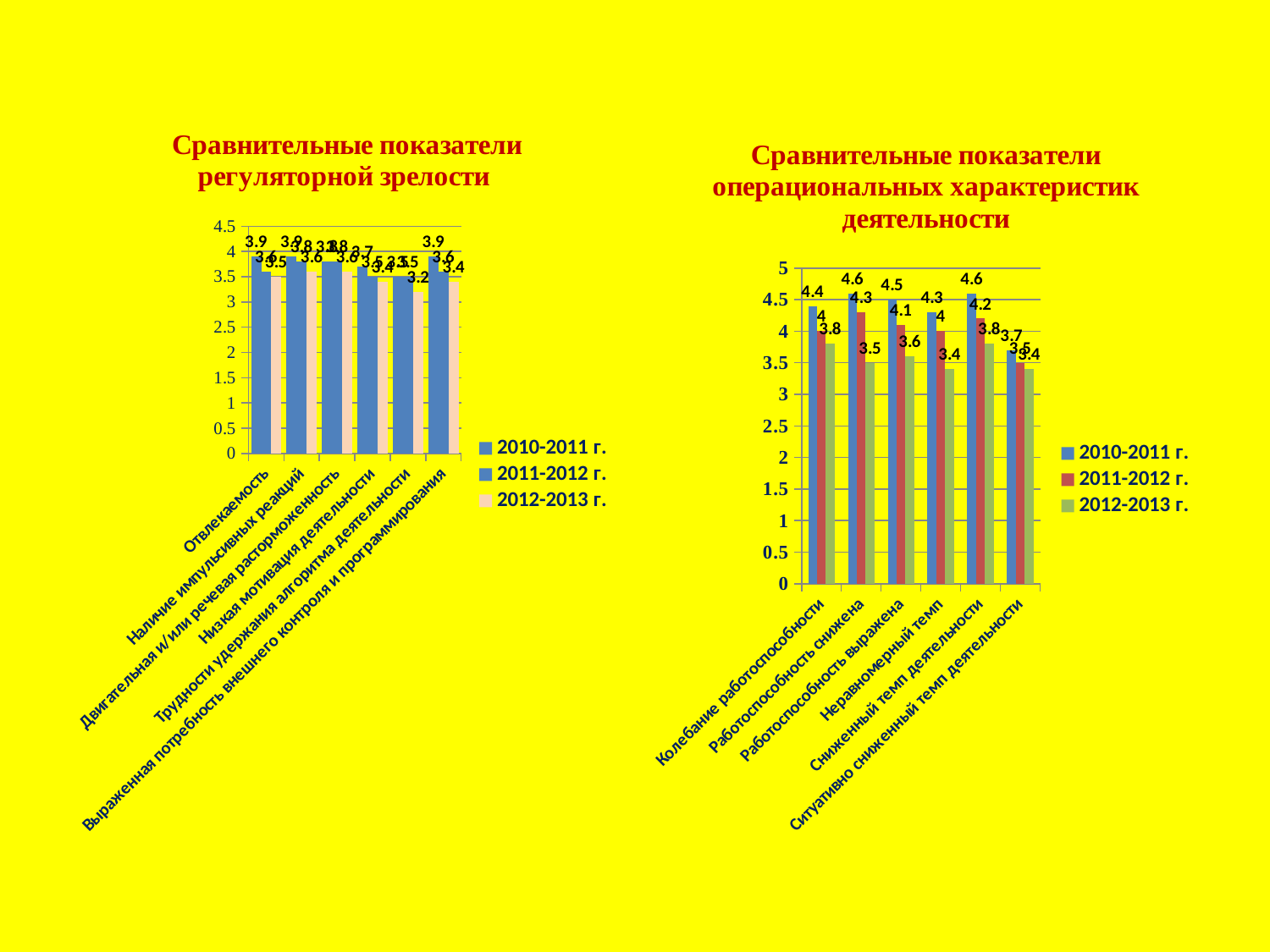
In the chart 'Сравнительные показатели операциональных характеристик деятельности', what is the difference between the 2010-2011 г. and 2012-2013 г. values for 'Работоспособность снижена'? 1.1 In the chart 'Сравнительные показатели операциональных характеристик деятельности', what is the value for 'Работоспособность снижена' in 2012-2013 г.? 3.5 What kind of chart is 'Сравнительные показатели регуляторной зрелости'? Bar chart In the chart 'Сравнительные показатели операциональных характеристик деятельности', which category has the lowest value for 2010-2011 г.? Ситуативно сниженный темп деятельности In the chart 'Сравнительные показатели операциональных характеристик деятельности', what is the value for 'Сниженный темп деятельности' in 2011-2012 г.? 4.2 In the chart 'Сравнительные показатели операциональных характеристик деятельности', what is the value for 'Колебание работоспособности' in 2010-2011 г.? 4.4 In the chart 'Сравнительные показатели операциональных характеристик деятельности', what is the value for 'Неравномерный темп' in 2011-2012 г.? 4 In the chart 'Сравнительные показатели операциональных характеристик деятельности', which is larger for 'Неравномерный темп': the 2010-2011 г. value or the 2012-2013 г. value? 2010-2011 г. In the chart 'Сравнительные показатели операциональных характеристик деятельности', how many categories are shown on the x axis? 6 In the chart 'Сравнительные показатели регуляторной зрелости', what is the value for 'Трудности удержания алгоритма деятельности' in 2012-2013 г.? 3.2 In the chart 'Сравнительные показатели регуляторной зрелости', what is the value for 'Выраженная потребность внешнего контроля и программирования' in 2010-2011 г.? 3.9 In the chart 'Сравнительные показатели операциональных характеристик деятельности', how many series does the legend list? 3